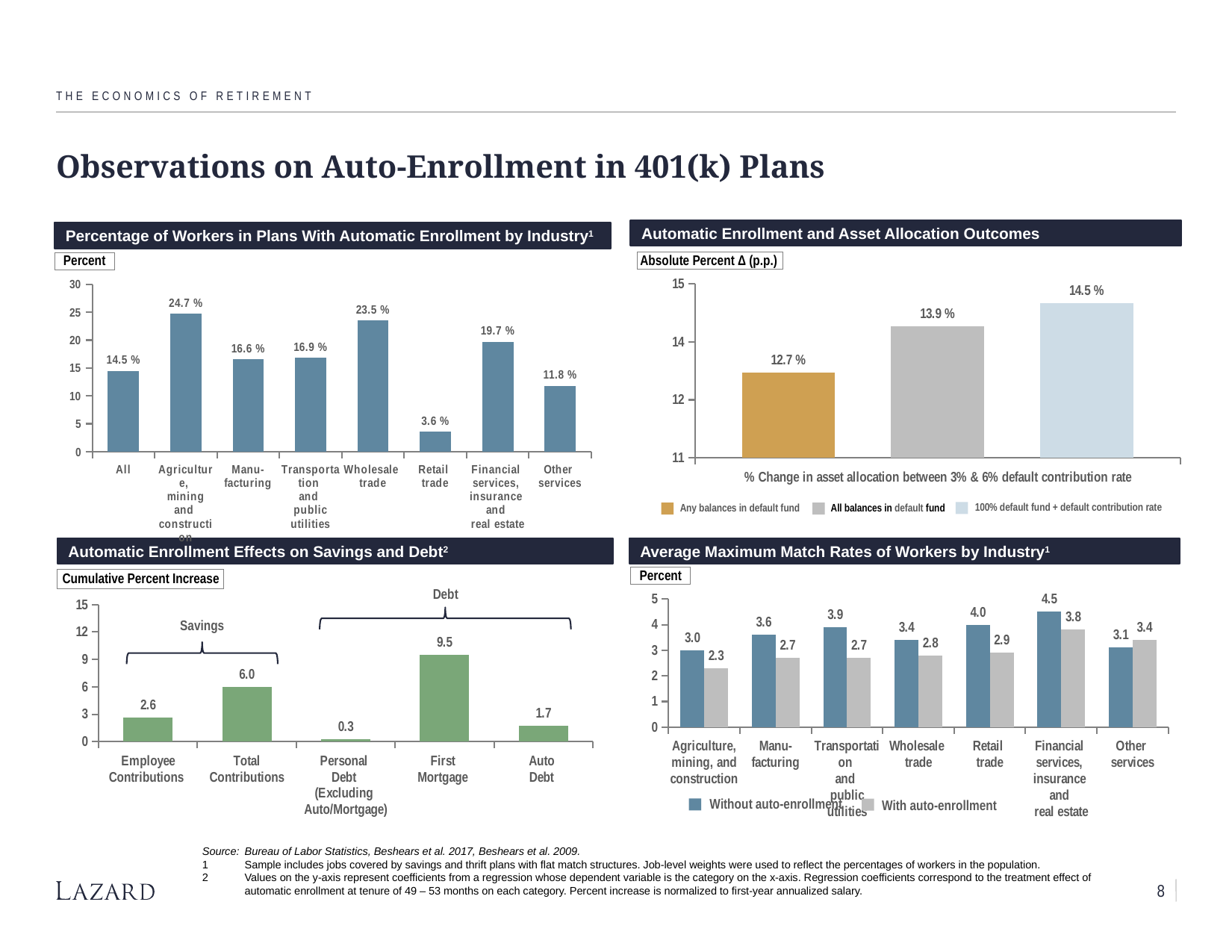
In the chart 'Percentage of Workers in Plans With Automatic Enrollment by Industry', what is the value for Retail trade? 3.6 % In the chart 'Automatic Enrollment Effects on Savings and Debt', what is the difference between Total Contributions and Employee Contributions? 3.4 In the chart 'Automatic Enrollment Effects on Savings and Debt', what is the value for First Mortgage? 9.5 In the chart 'Average Maximum Match Rates of Workers by Industry', which is larger for Other services: without auto-enrollment or with auto-enrollment? With auto-enrollment In the chart 'Percentage of Workers in Plans With Automatic Enrollment by Industry', which industry has the highest percentage? Agriculture, mining and construction What kind of chart is 'Average Maximum Match Rates of Workers by Industry'? Bar chart In the chart 'Automatic Enrollment and Asset Allocation Outcomes', what is the value for '100% default fund + default contribution rate'? 14.5 % In the chart 'Automatic Enrollment and Asset Allocation Outcomes', which series has the lowest value? Any balances in default fund In the chart 'Percentage of Workers in Plans With Automatic Enrollment by Industry', what is the difference between Wholesale trade and Other services? 11.7 % In the chart 'Automatic Enrollment and Asset Allocation Outcomes', how many series does the legend list? 3 In the chart 'Percentage of Workers in Plans With Automatic Enrollment by Industry', how many bars are plotted? 8 In the chart 'Average Maximum Match Rates of Workers by Industry', what is the value for Retail trade without auto-enrollment? 4.0